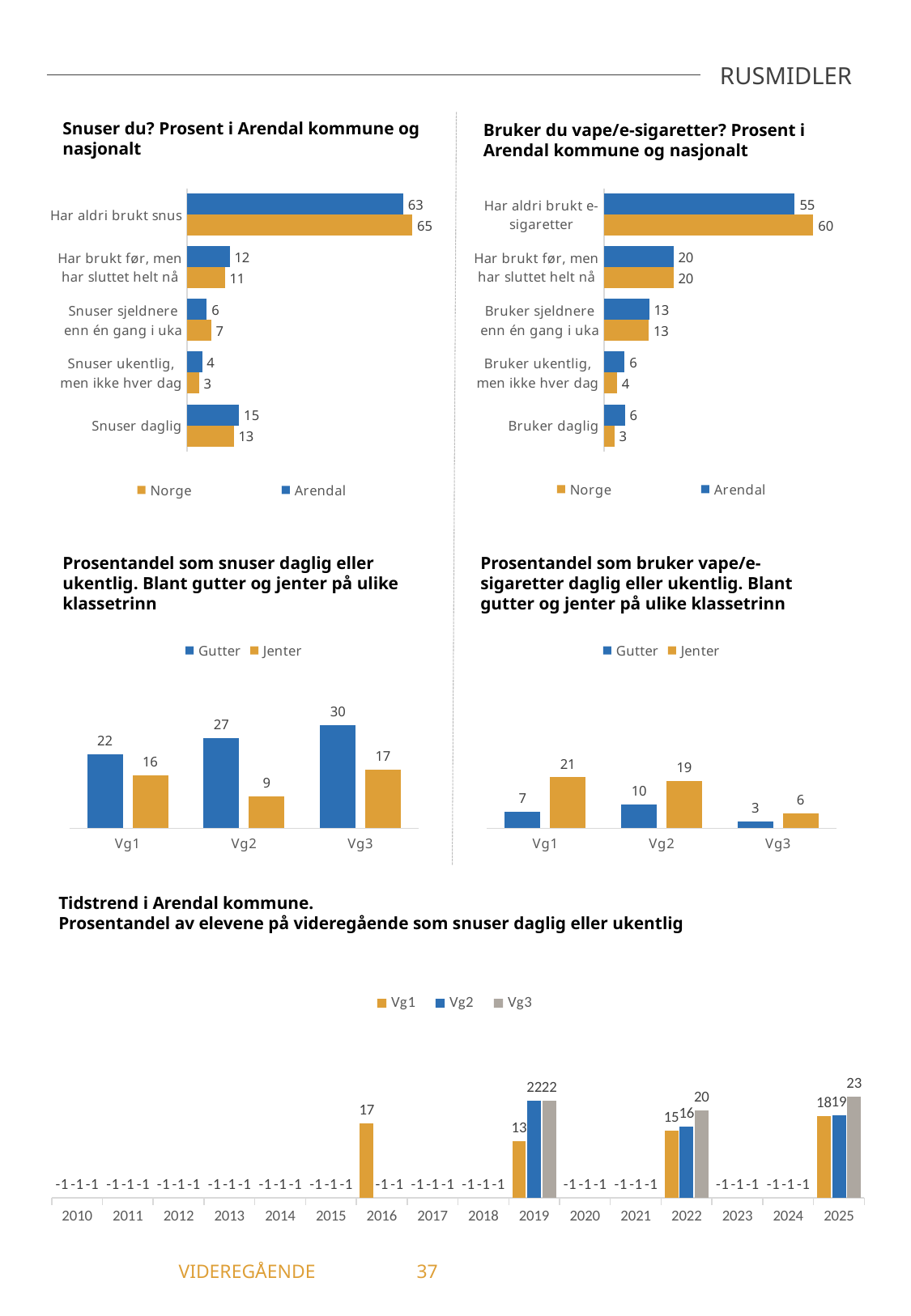
In the chart 'Prosentandel som snuser daglig eller ukentlig. Blant gutter og jenter på ulike klassetrinn', what is the value for Jenter at Vg2? 9 In the chart 'Snuser du? Prosent i Arendal kommune og nasjonalt', what is the value for Arendal for 'Har aldri brukt snus'? 63 In the chart 'Bruker du vape/e-sigaretter? Prosent i Arendal kommune og nasjonalt', which is larger for 'Bruker daglig': Arendal or Norge? Arendal In the chart 'Tidstrend i Arendal kommune', what is the value for Vg1 in 2016? 17 In the chart 'Snuser du? Prosent i Arendal kommune og nasjonalt', what is the difference between the Norge and Arendal values for 'Snuser daglig'? 2 In the chart 'Tidstrend i Arendal kommune', what is the value for Vg3 in 2025? 23 In the chart 'Prosentandel som bruker vape/e-sigaretter daglig eller ukentlig. Blant gutter og jenter på ulike klassetrinn', what is the difference between Jenter and Gutter at Vg1? 14 In the chart 'Bruker du vape/e-sigaretter? Prosent i Arendal kommune og nasjonalt', what is the value for Norge for 'Har aldri brukt e-sigaretter'? 60 In the chart 'Prosentandel som bruker vape/e-sigaretter daglig eller ukentlig. Blant gutter og jenter på ulike klassetrinn', which class level has the lowest value for Jenter? Vg3 How many series does the legend list in the chart 'Bruker du vape/e-sigaretter? Prosent i Arendal kommune og nasjonalt'? 2 In the chart 'Prosentandel som snuser daglig eller ukentlig. Blant gutter og jenter på ulike klassetrinn', which class level has the highest value for Gutter? Vg3 What kind of chart is 'Tidstrend i Arendal kommune'? Bar chart